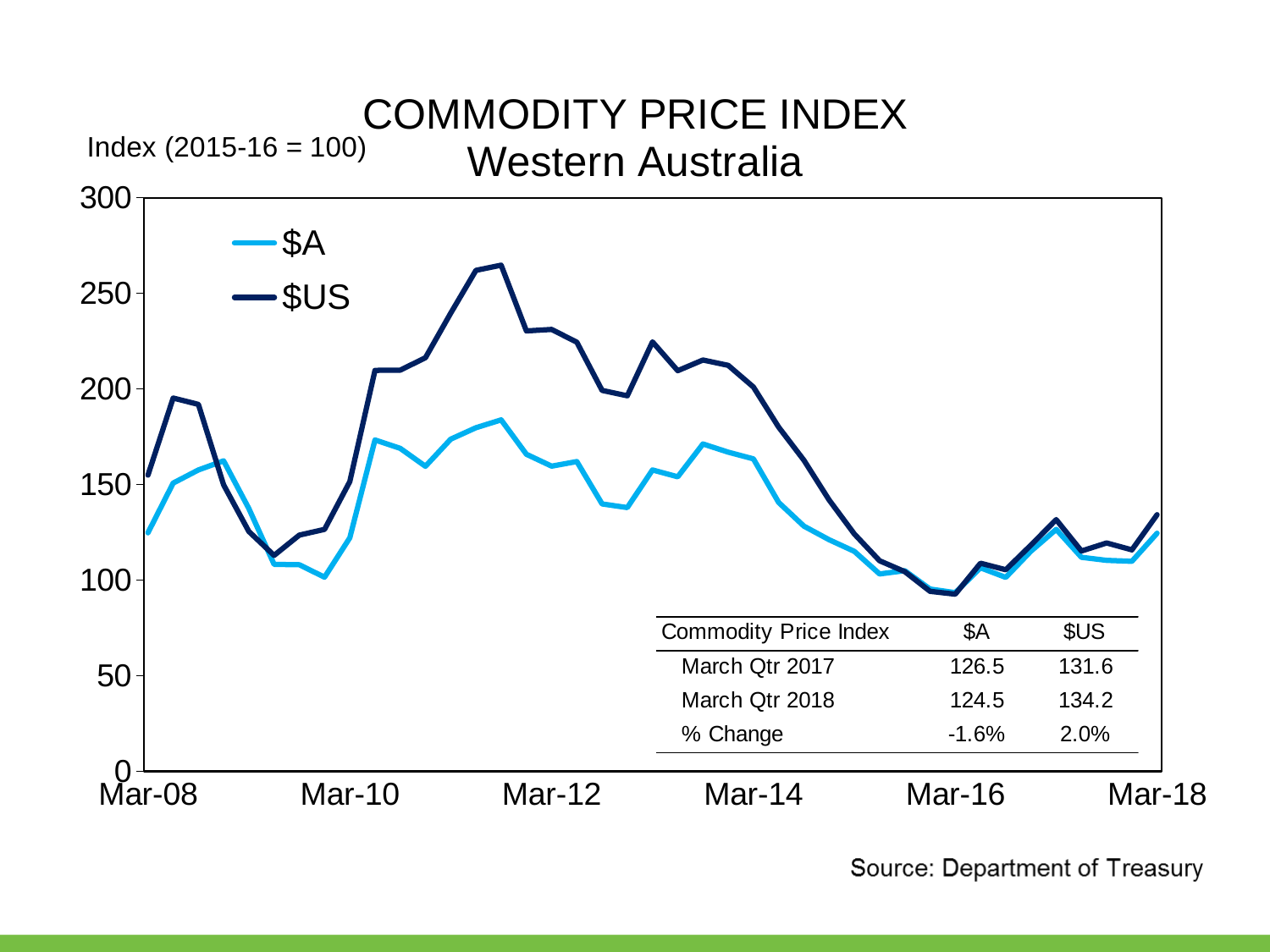
What is the difference between the $US index in March Qtr 2018 and March Qtr 2017, as given in the table? 2.6 Is the peak value of the $US series (around 2011-12) greater or less than 250? greater What base period is the index set to 100, according to the axis label? 2015-16 In March Qtr 2018, which is larger: the $A index or the $US index? $US Do the $A and $US series rise or fall between Mar-14 and Mar-16? fall What kind of chart is shown on the slide? line chart According to the table on the chart, what was the $US Commodity Price Index in March Qtr 2017? 131.6 Is the value of the $US series at Mar-16 greater or less than 100? less According to the table on the chart, what was the $A Commodity Price Index in March Qtr 2018? 124.5 What is the title of the chart? COMMODITY PRICE INDEX Western Australia How many series does the legend list? 2 What is the % change shown in the table for the $A index? -1.6%